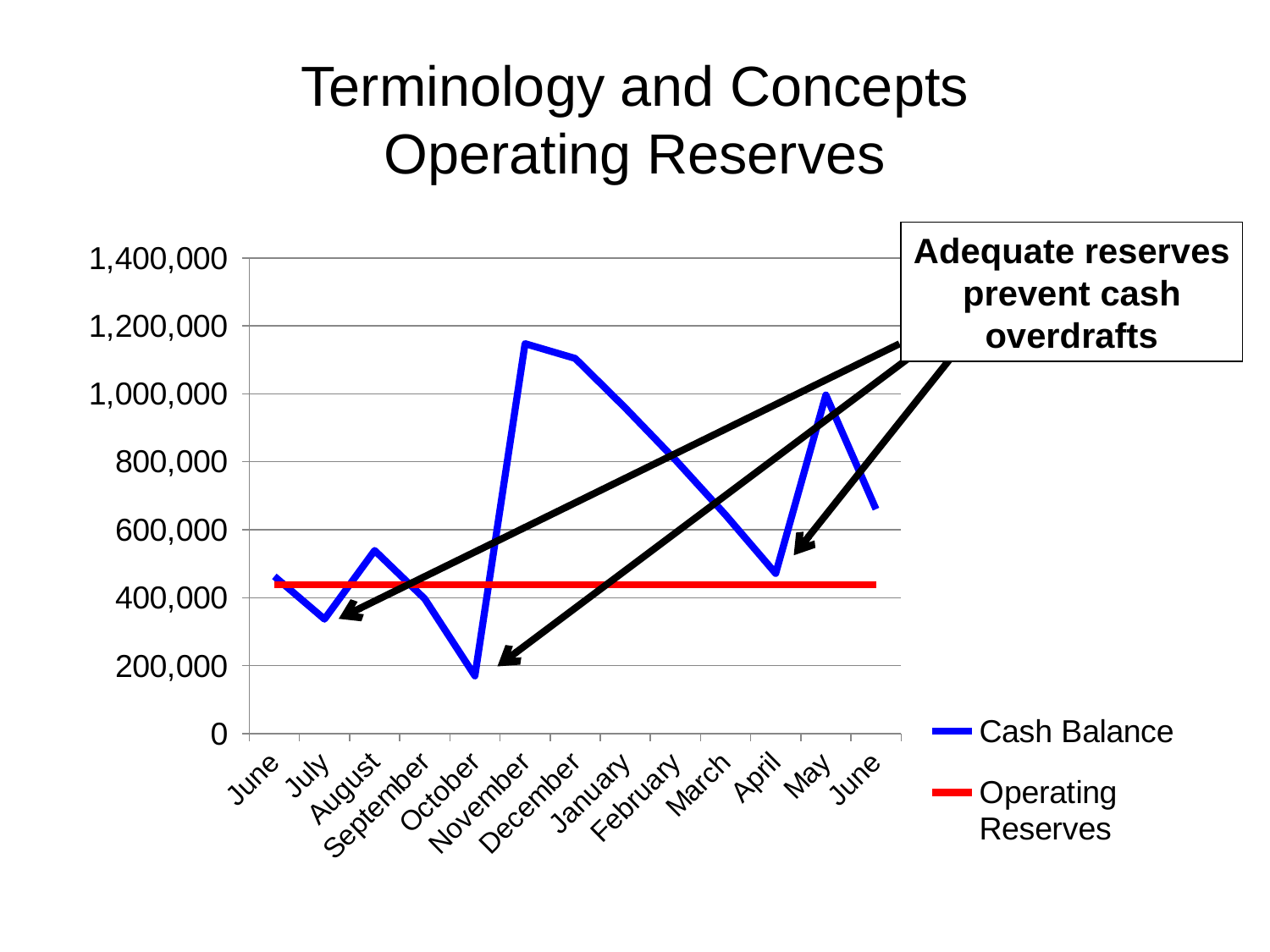
Is the Cash Balance for May greater or less than 800,000? greater What colour is the Operating Reserves line? red Is the Cash Balance for October greater or less than 200,000? less Is the Cash Balance for November greater or less than 1,000,000? greater How many months are shown along the x axis? 13 How many series does the legend list? 2 Which is larger, the Cash Balance in November or in May? November What kind of chart is shown on the slide? line chart Does the Cash Balance rise or fall from December to April? fall In which month is the Cash Balance lowest? October In which month is the Cash Balance highest? November